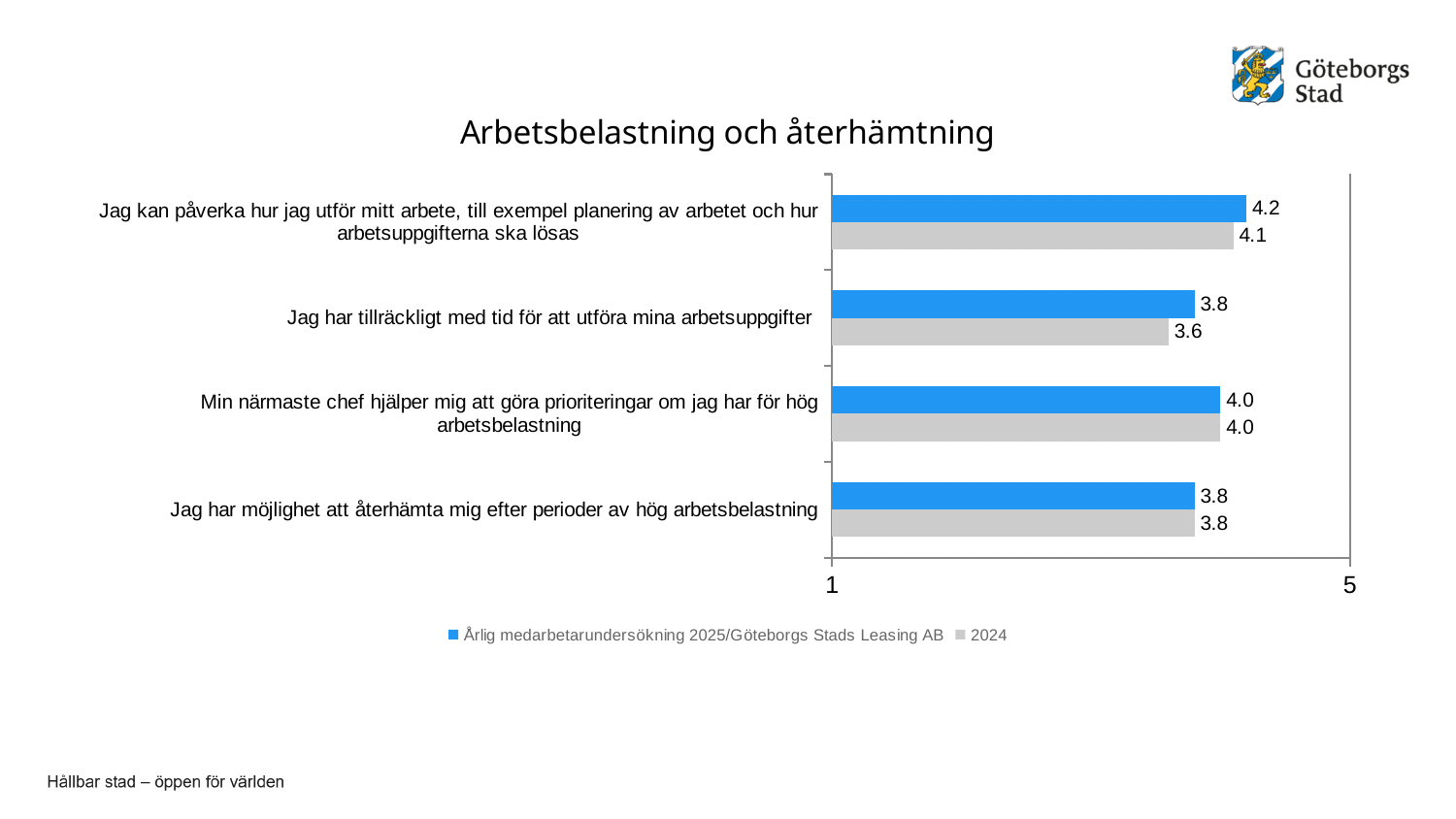
What is the title of the chart? Arbetsbelastning och återhämtning How many statements (categories) are shown in the chart? 4 For "Jag kan påverka hur jag utför mitt arbete...", is the 2025 value or the 2024 value larger? 2025 Which statement has the highest 2025 value? Jag kan påverka hur jag utför mitt arbete, till exempel planering av arbetet och hur arbetsuppgifterna ska lösas What is the 2024 value for "Jag kan påverka hur jag utför mitt arbete, till exempel planering av arbetet och hur arbetsuppgifterna ska lösas"? 4.1 How many series does the legend list? 2 Which statement has the lowest 2024 value? Jag har tillräckligt med tid för att utföra mina arbetsuppgifter Which colour represents the 2024 series? Grey What kind of chart is shown on the slide? Bar chart What is the 2025 value for "Jag har tillräckligt med tid för att utföra mina arbetsuppgifter"? 3.8 What is the difference between the 2025 and 2024 values for "Jag har tillräckligt med tid för att utföra mina arbetsuppgifter"? 0.2 What is the 2024 value for "Jag har tillräckligt med tid för att utföra mina arbetsuppgifter"? 3.6